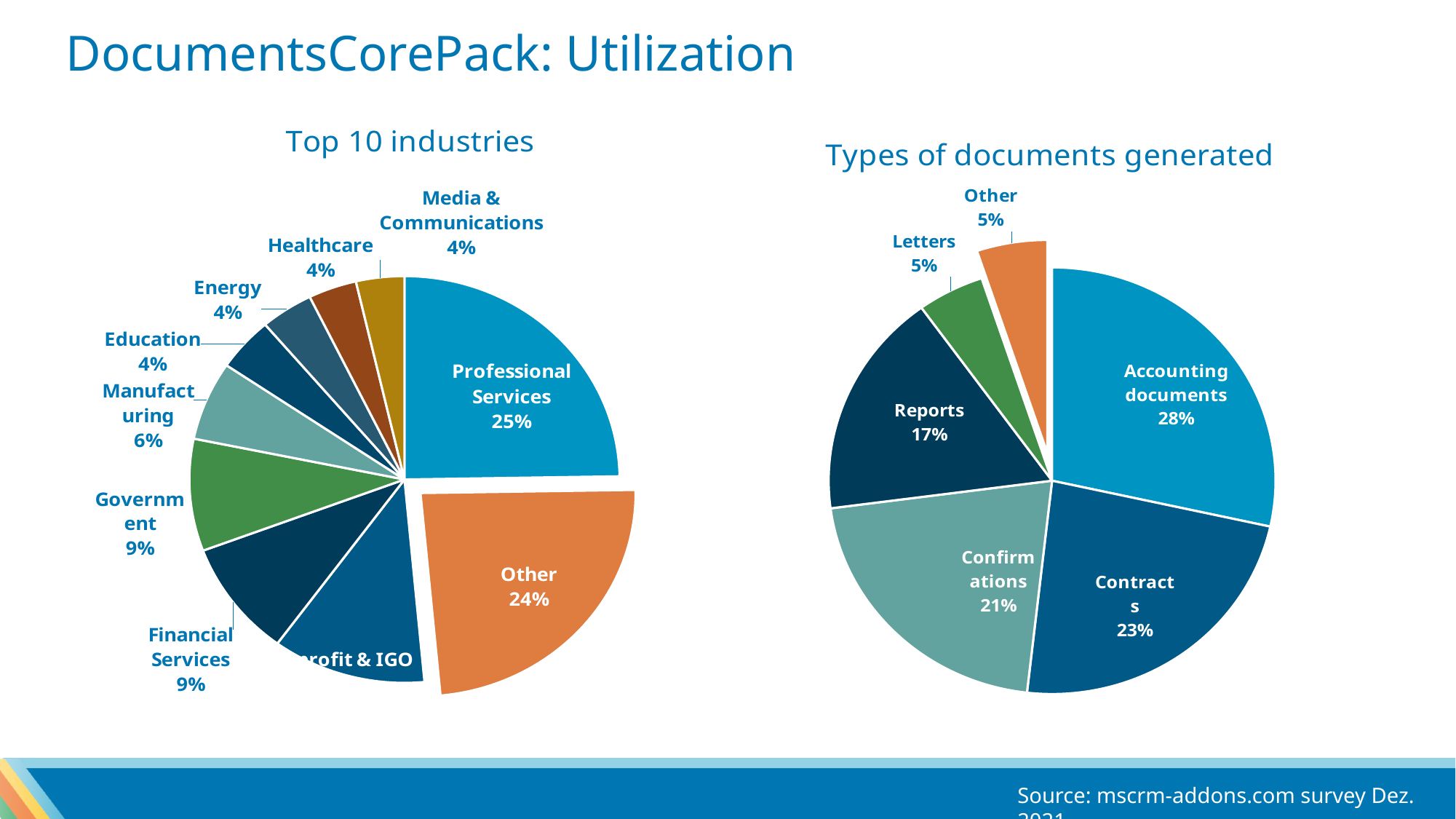
How many slices does the 'Top 10 industries' pie chart have? 10 How many slices does the 'Types of documents generated' pie chart have? 6 In the 'Top 10 industries' chart, what share does Professional Services have? 25% In the 'Types of documents generated' chart, which slice is pulled out from the pie? Other In the 'Types of documents generated' chart, what share do Contracts have? 23% In the 'Top 10 industries' chart, what share does Manufacturing have? 6% What type of chart is 'Types of documents generated'? Pie chart In the 'Top 10 industries' chart, which is larger: Professional Services or Other? Professional Services In the 'Top 10 industries' chart, what is the difference between the Other slice and the Government slice? 15% In the 'Types of documents generated' chart, what is the difference between Accounting documents and Reports? 11% In the 'Top 10 industries' chart, which industry has the largest share? Professional Services In the 'Types of documents generated' chart, which document type has the largest share? Accounting documents